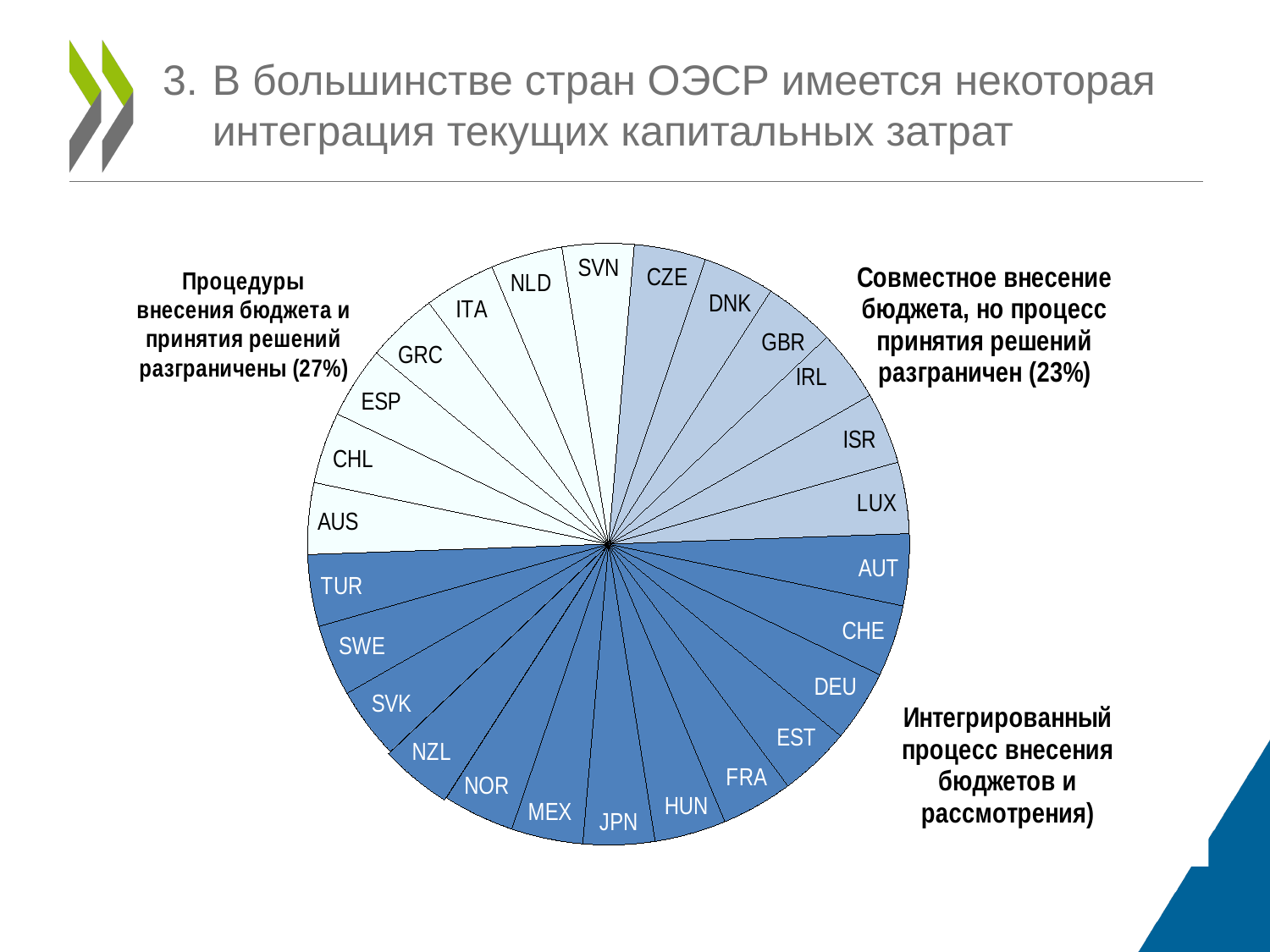
Which colour is used for the slices of the group "Интегрированный процесс внесения бюджетов и рассмотрения"? dark blue What is the difference in percentage points between the 27% group and the 23% group? 4 How many country slices does the pie chart contain in total? 26 What kind of chart is shown on the slide? pie chart How many countries are in the group "Процедуры внесения бюджета и принятия решений разграничены (27%)"? 7 How many countries are in the dark blue group "Интегрированный процесс внесения бюджетов и рассмотрения"? 13 What share of the pie is labelled "Процедуры внесения бюджета и принятия решений разграничены"? 27% What share of the pie is labelled "Совместное внесение бюджета, но процесс принятия решений разграничен"? 23% Which of the three groups in the pie chart contains the fewest countries? Совместное внесение бюджета, но процесс принятия решений разграничен (23%) Which of the three groups in the pie chart contains the most countries? Интегрированный процесс внесения бюджетов и рассмотрения Which group has the larger share of the pie: the one at 27% or the one at 23%? Процедуры внесения бюджета и принятия решений разграничены (27%)